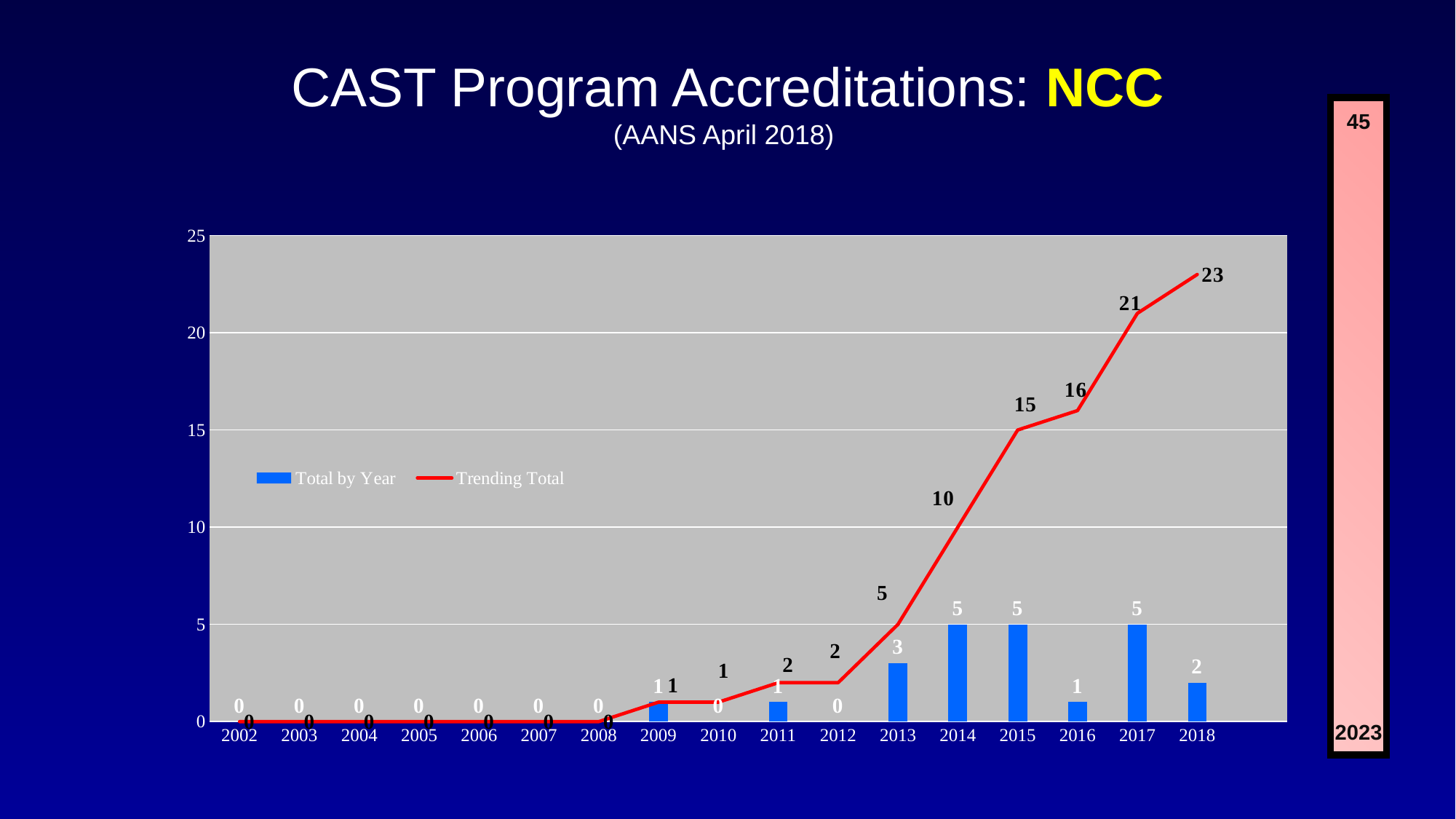
How many years are shown on the x axis? 17 Does the Trending Total line rise or fall from 2012 to 2018? rise What is the Total by Year value for 2013? 3 In which year does the Trending Total reach its highest value? 2018 Which is larger, the Total by Year for 2013 or for 2016? 2013 What is the difference between the Trending Total in 2018 and in 2017? 2 What is the Trending Total value for 2014? 10 How many series does the legend list? 2 What is the Trending Total value for 2017? 21 What is the Total by Year value for 2018? 2 Is the Trending Total for 2015 greater or less than 10? greater What is the difference between the Total by Year in 2014 and in 2016? 4